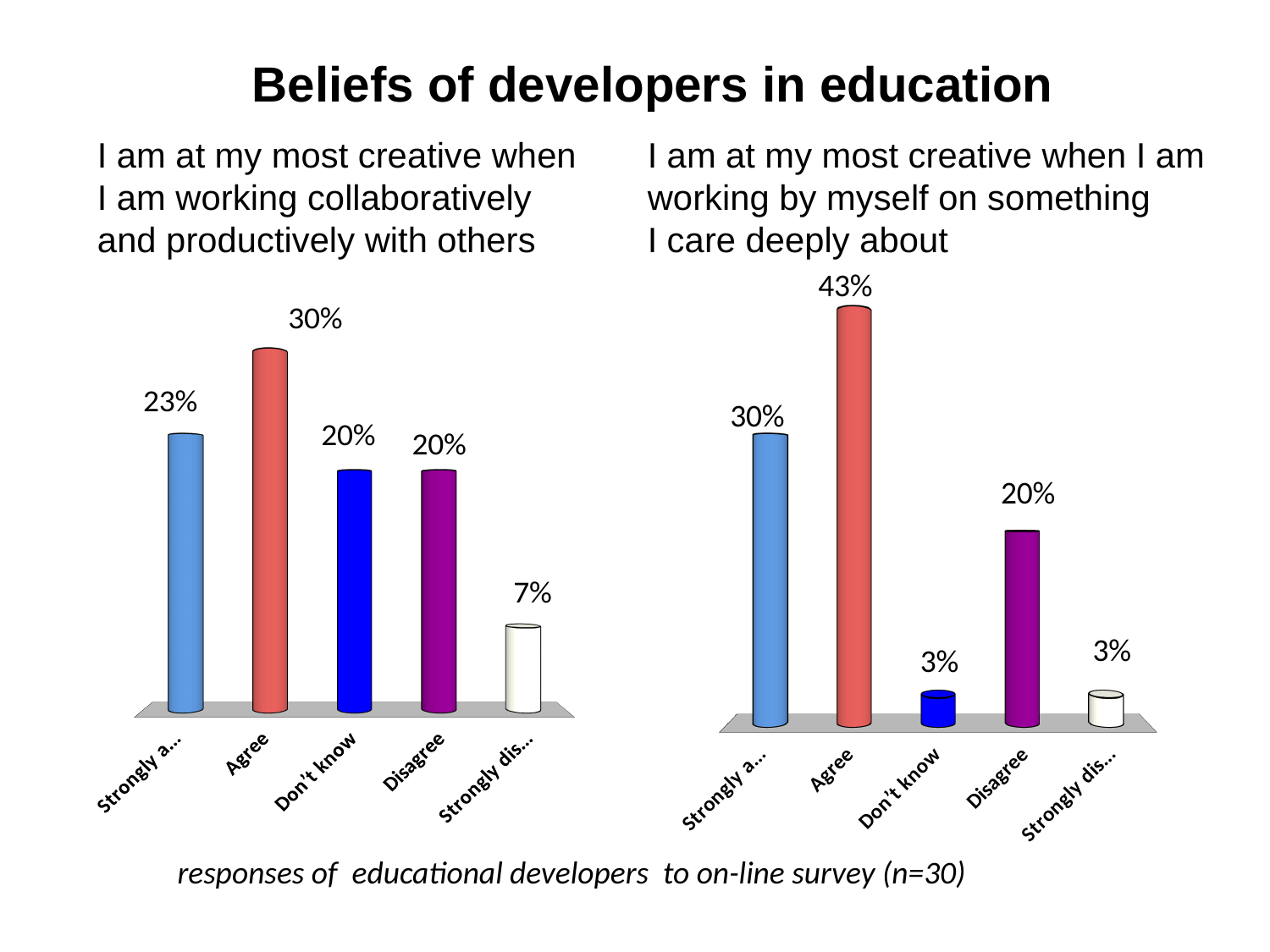
Which chart has the larger value for Agree, the left chart or the right chart? The right chart In the right chart (working by myself on something I care deeply about), which response category has the lowest value? Don't know and Strongly disagree (both 3%) What type of chart is used on this slide? Bar chart In the right chart (working by myself on something I care deeply about), what percentage of respondents chose Agree? 43% In the left chart (working collaboratively with others), what percentage of respondents chose Agree? 30% In the right chart (working by myself on something I care deeply about), what is the difference between Agree and Disagree? 23% In the left chart (working collaboratively with others), which response category has the highest value? Agree In the left chart (working collaboratively with others), what is the value for Don't know? 20% In the left chart (working collaboratively with others), which response category has the lowest value? Strongly disagree In the left chart (working collaboratively with others), what is the difference between Agree and Strongly disagree? 23% How many response categories are shown in the left chart (working collaboratively with others)? 5 In the right chart (working by myself on something I care deeply about), what is the value for Don't know? 3%